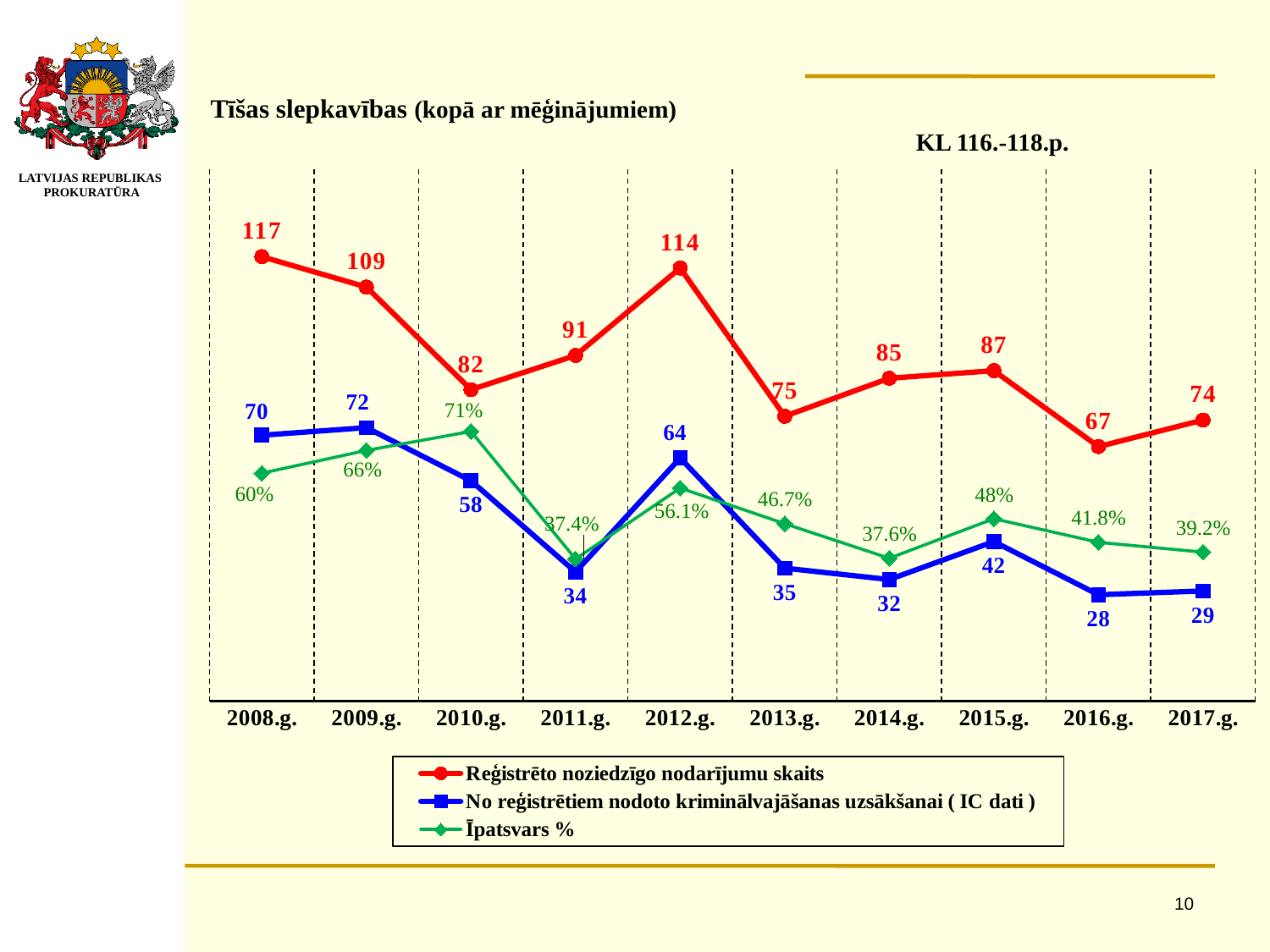
Does 'No reģistrētiem nodoto kriminālvajāšanas uzsākšanai ( IC dati )' rise or fall from 2015.g. to 2016.g.? fall How many years are shown on the x axis? 10 How many series does the legend list? 3 In which year is 'No reģistrētiem nodoto kriminālvajāšanas uzsākšanai ( IC dati )' lowest? 2016.g. Which is larger: 'Reģistrēto noziedzīgo nodarījumu skaits' in 2013.g. or in 2014.g.? 2014.g. In which year is 'Reģistrēto noziedzīgo nodarījumu skaits' highest? 2008.g. What is the value of 'Reģistrēto noziedzīgo nodarījumu skaits' in 2012.g.? 114 What kind of chart is shown on the slide? line chart What is the value of 'No reģistrētiem nodoto kriminālvajāšanas uzsākšanai ( IC dati )' in 2015.g.? 42 In which year is 'Īpatsvars %' highest? 2010.g. What is the difference between 'Reģistrēto noziedzīgo nodarījumu skaits' and 'No reģistrētiem nodoto kriminālvajāšanas uzsākšanai ( IC dati )' in 2008.g.? 47 What is the 'Īpatsvars %' value for 2011.g.? 37.4%